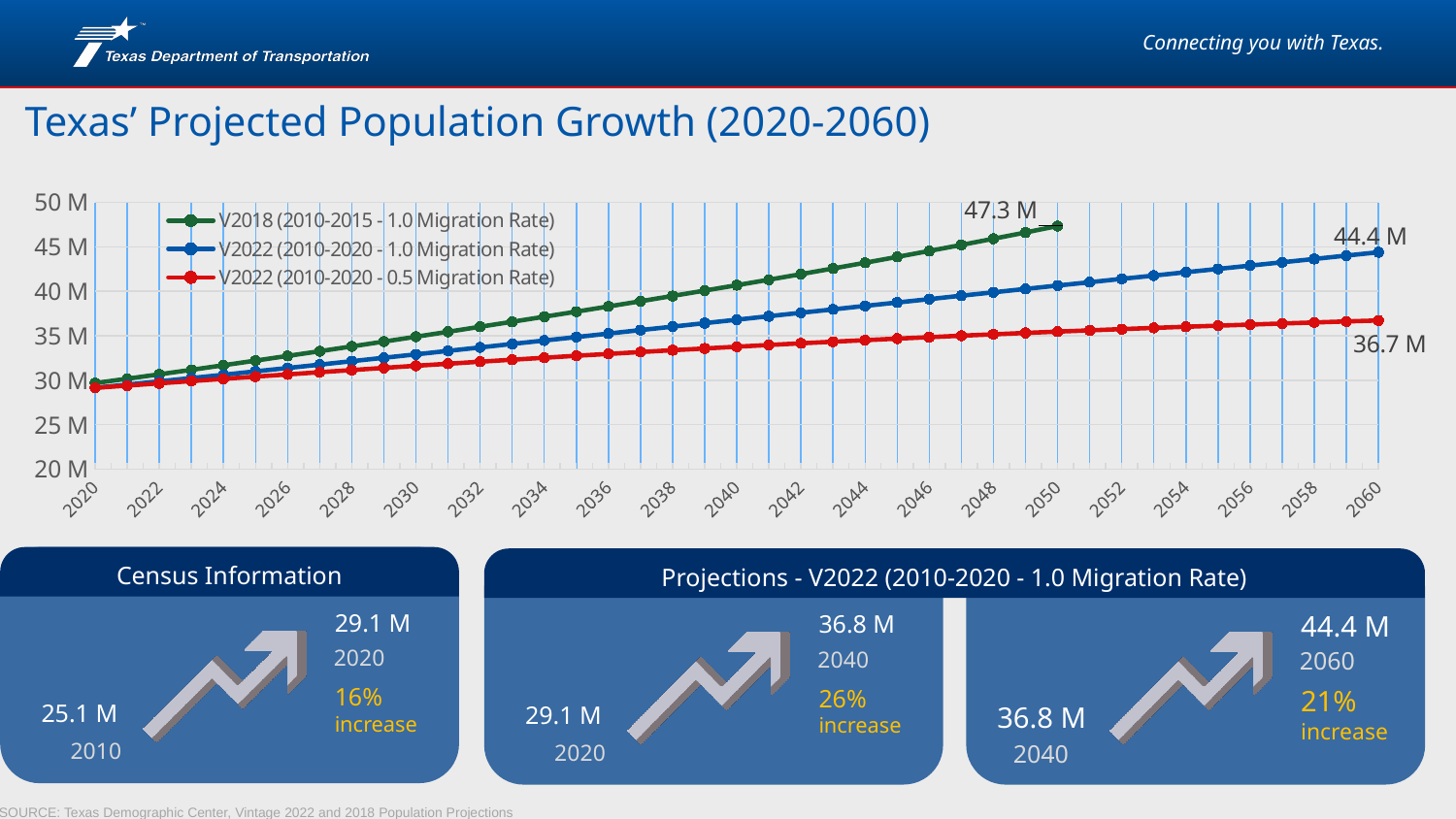
What type of chart is shown on the slide? Line chart In 2060, which is larger: the V2022 1.0 Migration Rate value or the V2022 0.5 Migration Rate value? V2022 1.0 Migration Rate Do the values of the V2018 (2010-2015 - 1.0 Migration Rate) series rise or fall from 2020 to 2050? rise What is the title of the chart? Texas' Projected Population Growth (2020-2060) Is the value for the V2022 (2010-2020 - 1.0 Migration Rate) series in 2040 greater or less than 40 M? less What is the labelled value of the V2022 (2010-2020 - 0.5 Migration Rate) series in 2060? 36.7 M What is the difference between the 2060 values of the V2022 1.0 Migration Rate series and the V2022 0.5 Migration Rate series? 7.7 M What is the labelled value of the V2018 (2010-2015 - 1.0 Migration Rate) series at the end of its line in 2050? 47.3 M What is the labelled value of the V2022 (2010-2020 - 1.0 Migration Rate) series in 2060? 44.4 M How many series does the chart legend list? 3 Which series reaches the highest value on the chart? V2018 (2010-2015 - 1.0 Migration Rate) Which series has the lowest value in 2060? V2022 (2010-2020 - 0.5 Migration Rate)